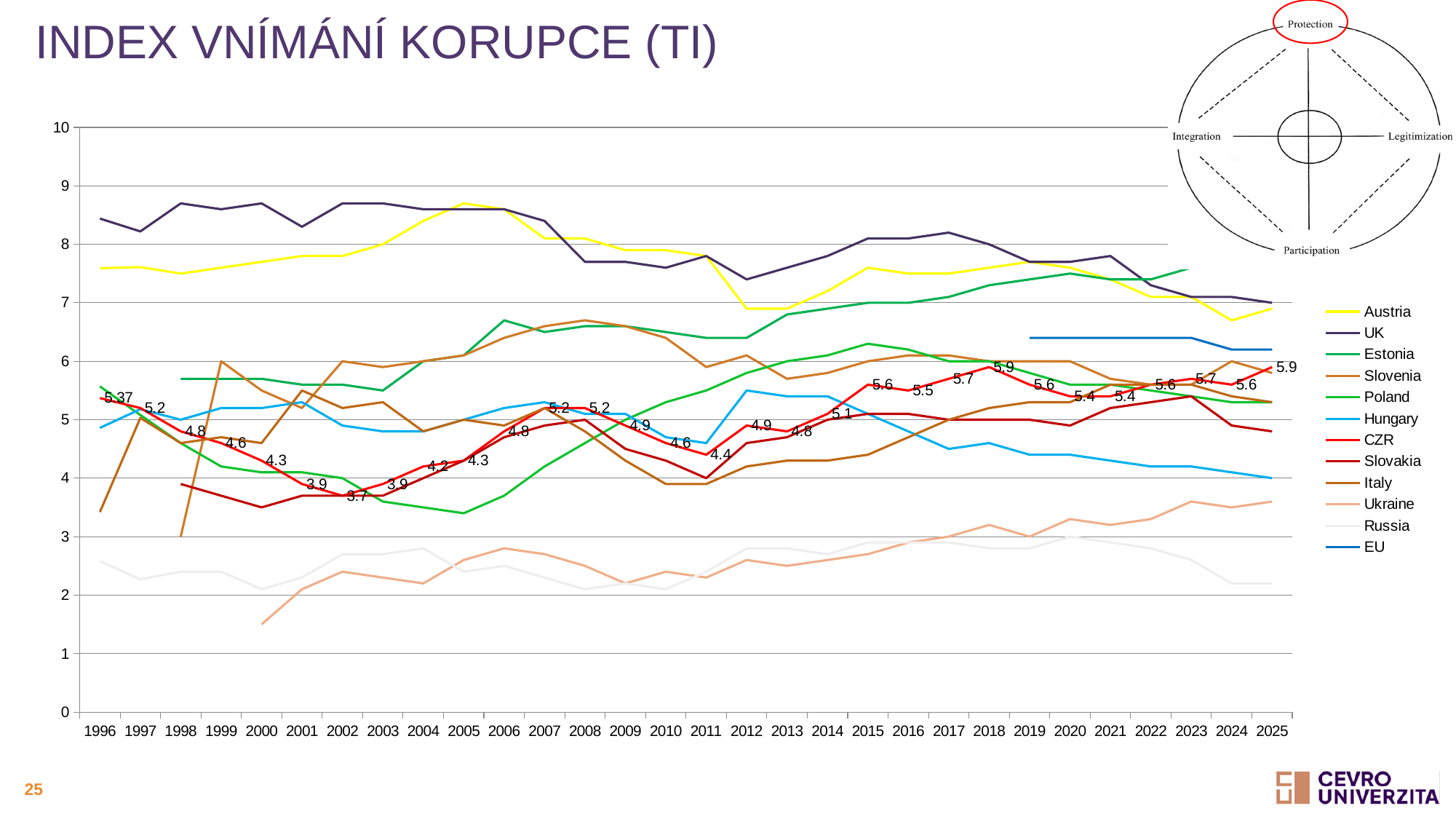
How many years are shown on the x axis? 30 Is the value for UK in 1996 greater or less than 8? greater Which is larger in 2025, the value for Austria or the value for Hungary? Austria How many series does the legend list? 12 What is the value for CZR in 2002? 3.7 What kind of chart is shown on the slide? line chart What is the difference between the CZR value in 2025 and in 2002? 2.2 What is the value for CZR in 1996? 5.37 In which year does the CZR line reach its lowest value? 2002 Does the Hungary line rise or fall from 2012 to 2025? fall What is the value for CZR in 2025? 5.9 Is the value for Ukraine in 2000 greater or less than 2? less